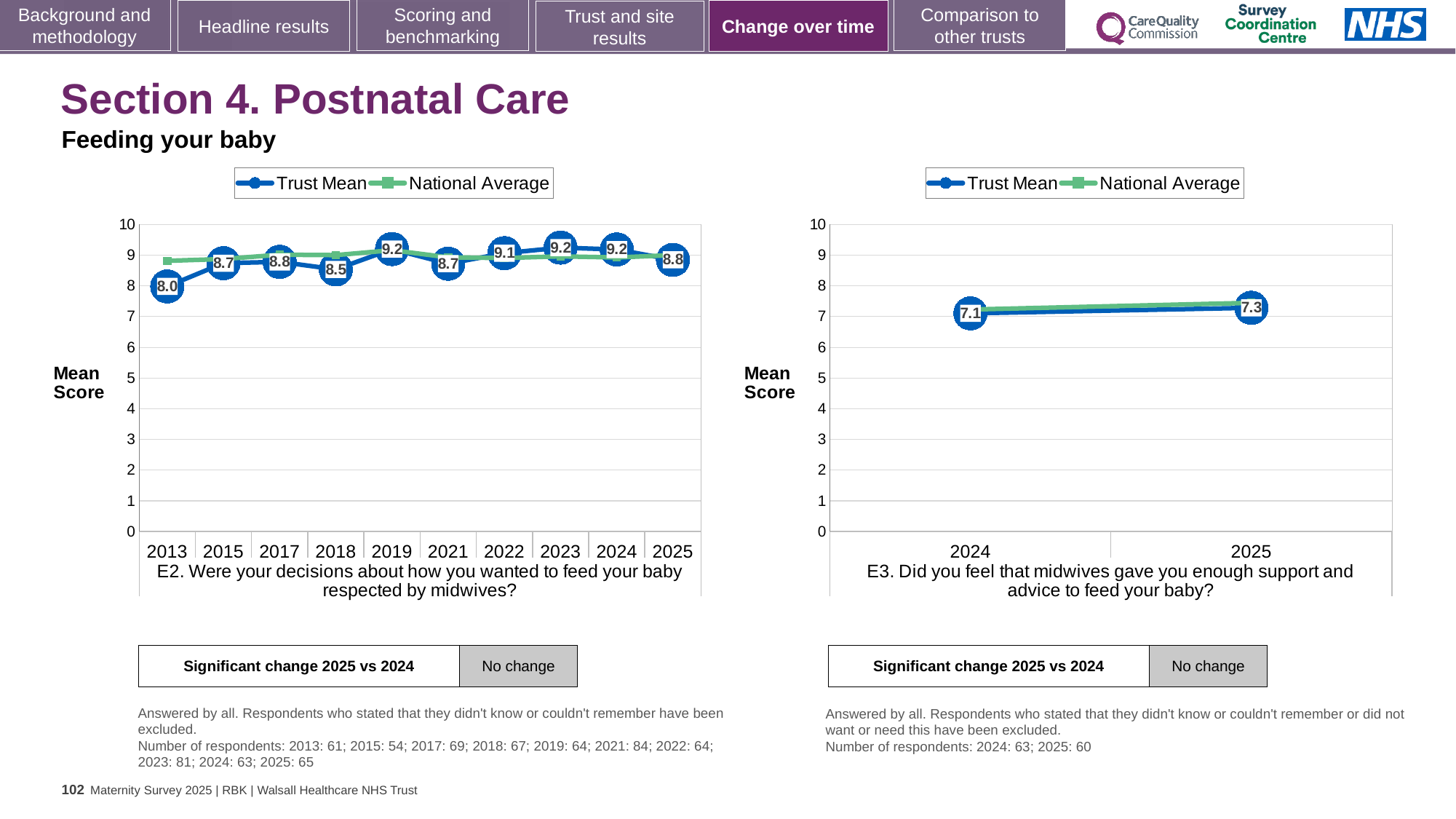
In the E2 chart on the left, which year has the lowest Trust Mean? 2013 In the E2 chart on the left, what is the difference between the Trust Mean in 2025 and in 2013? 0.8 In the E2 chart on the left, what is the Trust Mean for 2013? 8.0 In the E3 chart on the right, is the Trust Mean for 2025 greater or less than 8? less In the E3 chart on the right, what is the Trust Mean for 2024? 7.1 How many years are plotted on the x axis of the E2 chart on the left? 10 In the E3 chart on the right, does the Trust Mean rise or fall from 2024 to 2025? rise In the E2 chart on the left, what is the Trust Mean for 2019? 9.2 How many series does the legend of the E3 chart on the right list? 2 In the E3 chart on the right, what is the Trust Mean for 2025? 7.3 In the E2 chart on the left, is the Trust Mean higher in 2018 or in 2022? 2022 In the E2 chart on the left, what is the Trust Mean for 2025? 8.8